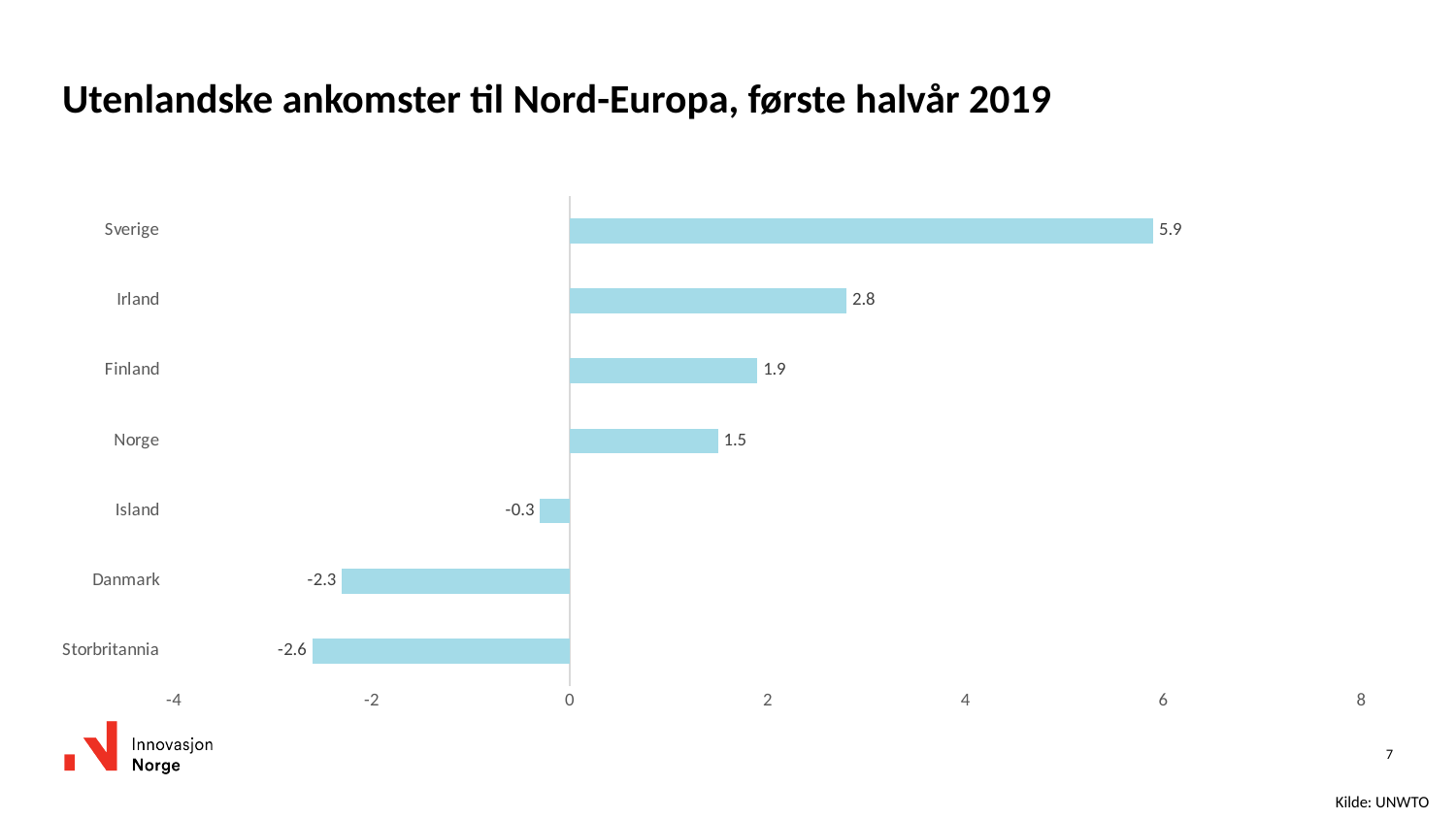
Which has a larger value, Finland or Norge? Finland How many countries are shown in the chart? 7 What is the value for Sverige? 5.9 What is the title of the chart? Utenlandske ankomster til Nord-Europa, første halvår 2019 What kind of chart is shown on the slide? Bar chart What is the value for Island? -0.3 What is the difference between the values for Sverige and Irland? 3.1 What is the value for Norge? 1.5 Which country has the highest value? Sverige Which country has the lowest value? Storbritannia What is the value for Storbritannia? -2.6 Is the value for Irland greater or less than 2? greater